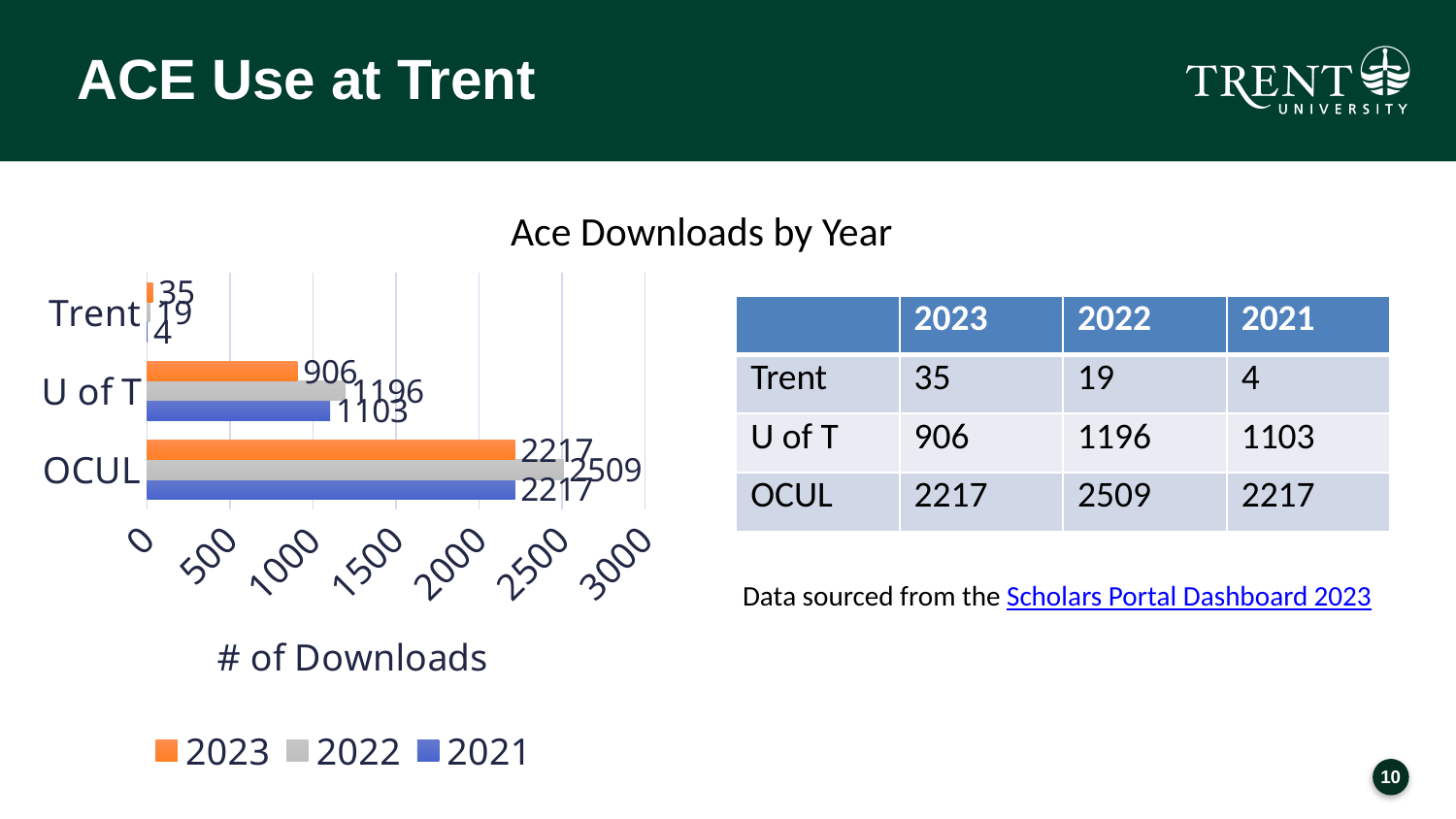
Which category has the lowest value in 2023? Trent How many categories are shown on the chart? 3 What is the value for U of T in 2022? 1196 What is the label of the x axis? # of Downloads What is the difference between the 2022 and 2023 values for OCUL? 292 What is the chart's title? Ace Downloads by Year What is the value for Trent in 2023? 35 What type of chart is shown on the slide? bar chart Which category has the highest value in 2021? OCUL How many series does the legend list? 3 What is the value for OCUL in 2022? 2509 Which is larger for U of T: the 2021 value or the 2023 value? 2021